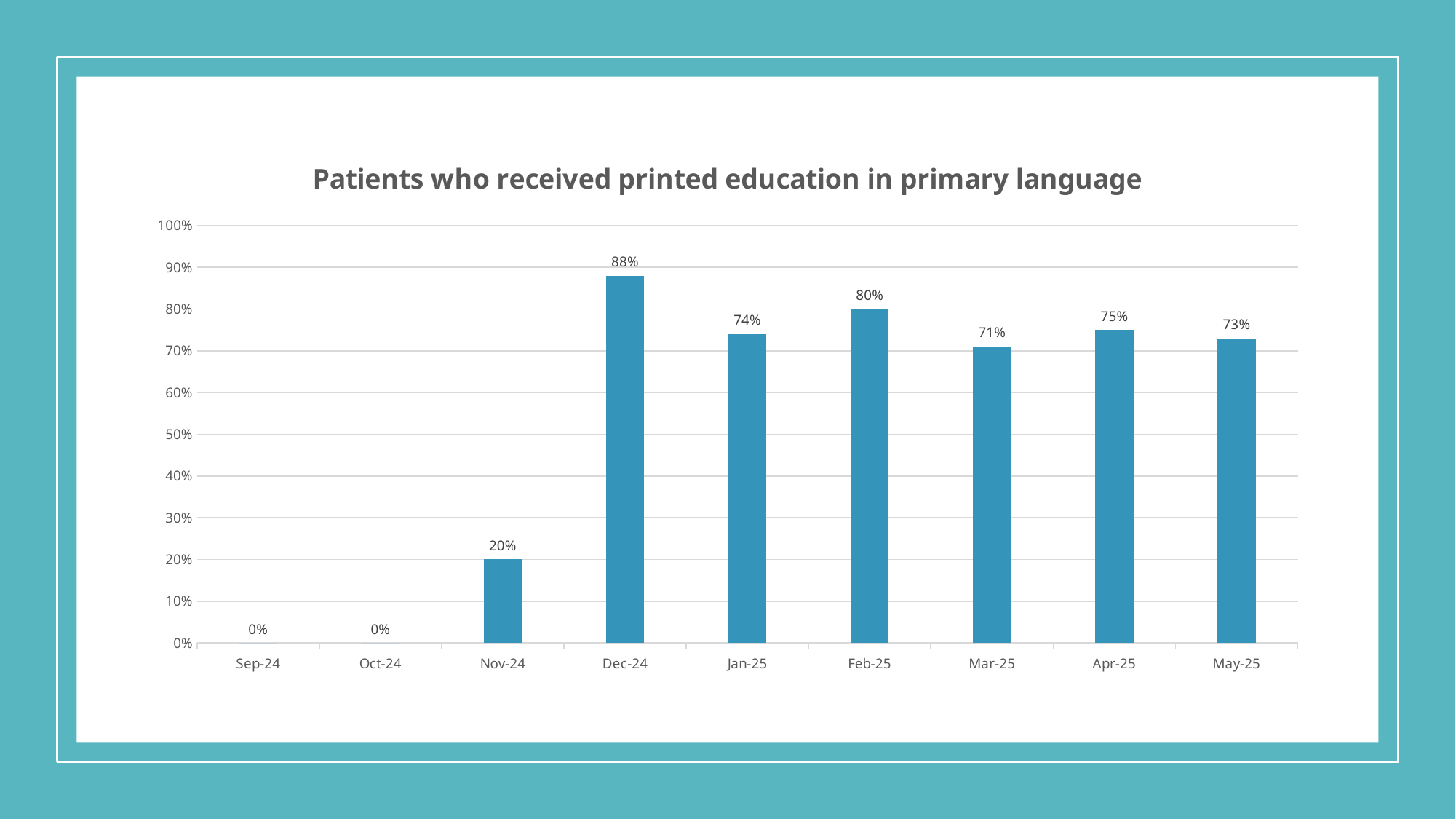
Do the values rise or fall from Sep-24 to Dec-24? rise What is the difference between the values for Dec-24 and Jan-25? 14% What is the value for Nov-24? 20% How many months are shown on the x axis? 9 Is the value for May-25 greater or less than 70%? greater What is the value for Dec-24? 88% What is the value for Mar-25? 71% Which is larger, the value for Feb-25 or the value for Apr-25? Feb-25 Which month has the lowest non-zero value? Nov-24 What is the title of the chart? Patients who received printed education in primary language What kind of chart is this? bar chart Which month has the highest value? Dec-24